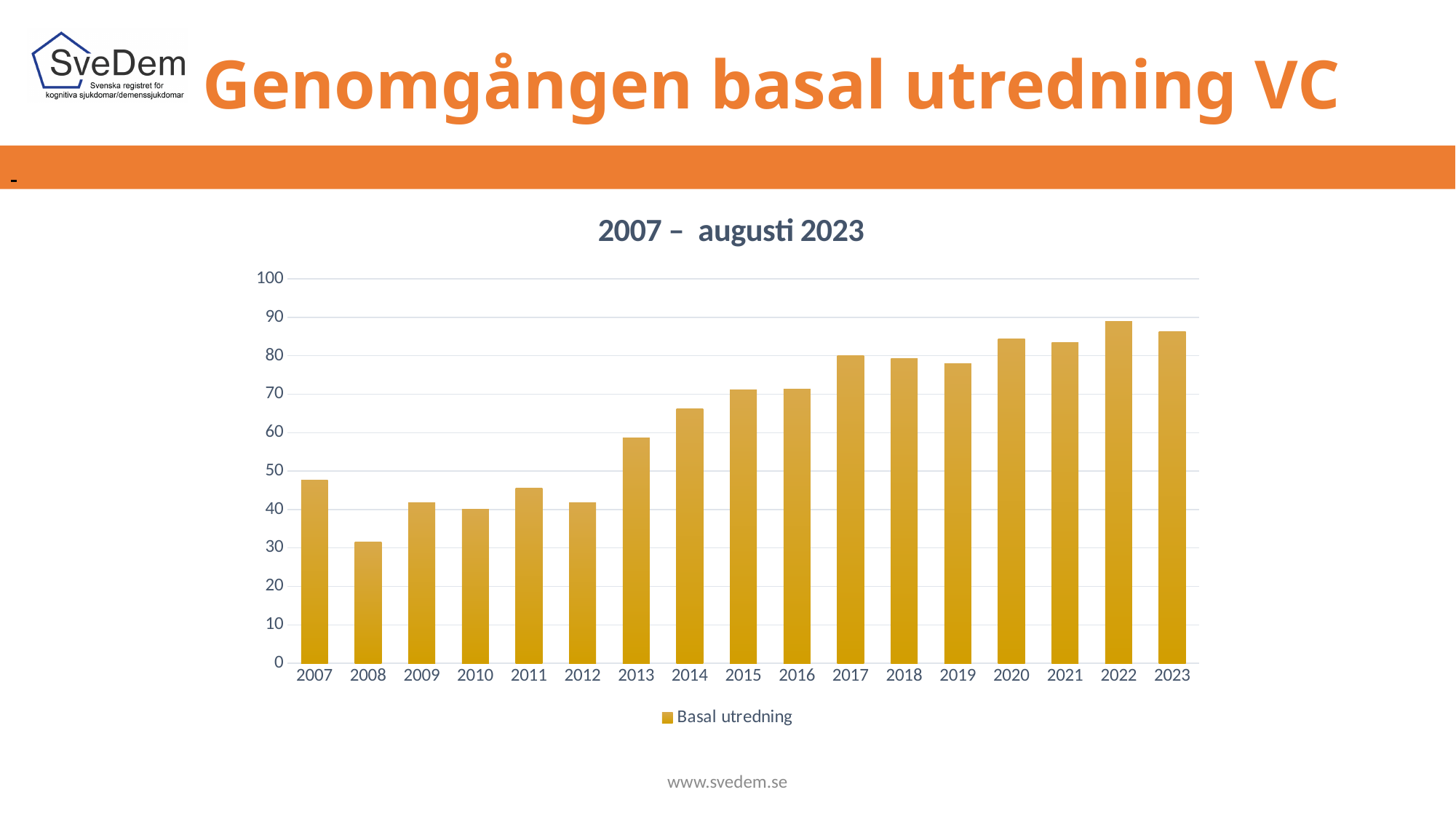
Which year has the lowest value in the chart? 2008 Is the value for 2008 greater or less than 40? less What is the name of the series shown in the chart's legend? Basal utredning How many series does the chart's legend list? 1 Is the value for 2013 greater or less than 50? greater Is the value for 2014 greater or less than 60? greater Which year has the larger value, 2012 or 2013? 2013 How many years are shown on the x axis of the chart? 17 What kind of chart is shown on the slide? bar chart Which year has the highest value in the chart? 2022 Do the values generally rise or fall from 2007 to 2023? rise